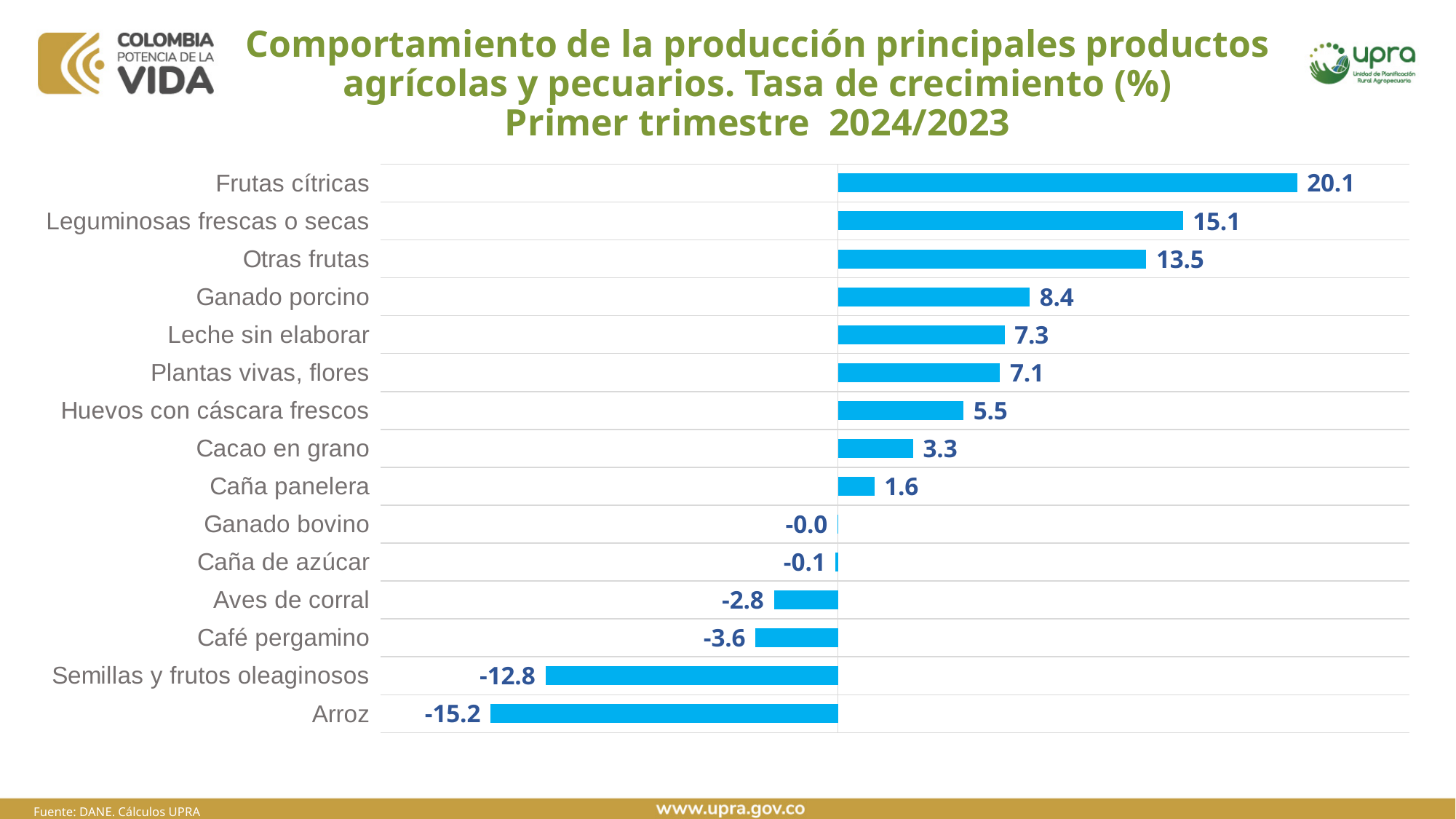
What is the value shown for Leche sin elaborar? 7.3 What is the value shown for Semillas y frutos oleaginosos? -12.8 What is the growth rate shown for Frutas cítricas? 20.1 Which has a larger value, Otras frutas or Ganado porcino? Otras frutas Which category has the highest growth rate? Frutas cítricas What is the difference between the values for Frutas cítricas and Leguminosas frescas o secas? 5.0 How many categories are shown in the chart? 15 What is the source cited at the bottom of the slide? DANE. Cálculos UPRA What kind of chart is shown on the slide? Bar chart What is the difference between the values for Ganado porcino and Cacao en grano? 5.1 What is the value shown for Arroz? -15.2 Which category has the lowest growth rate? Arroz